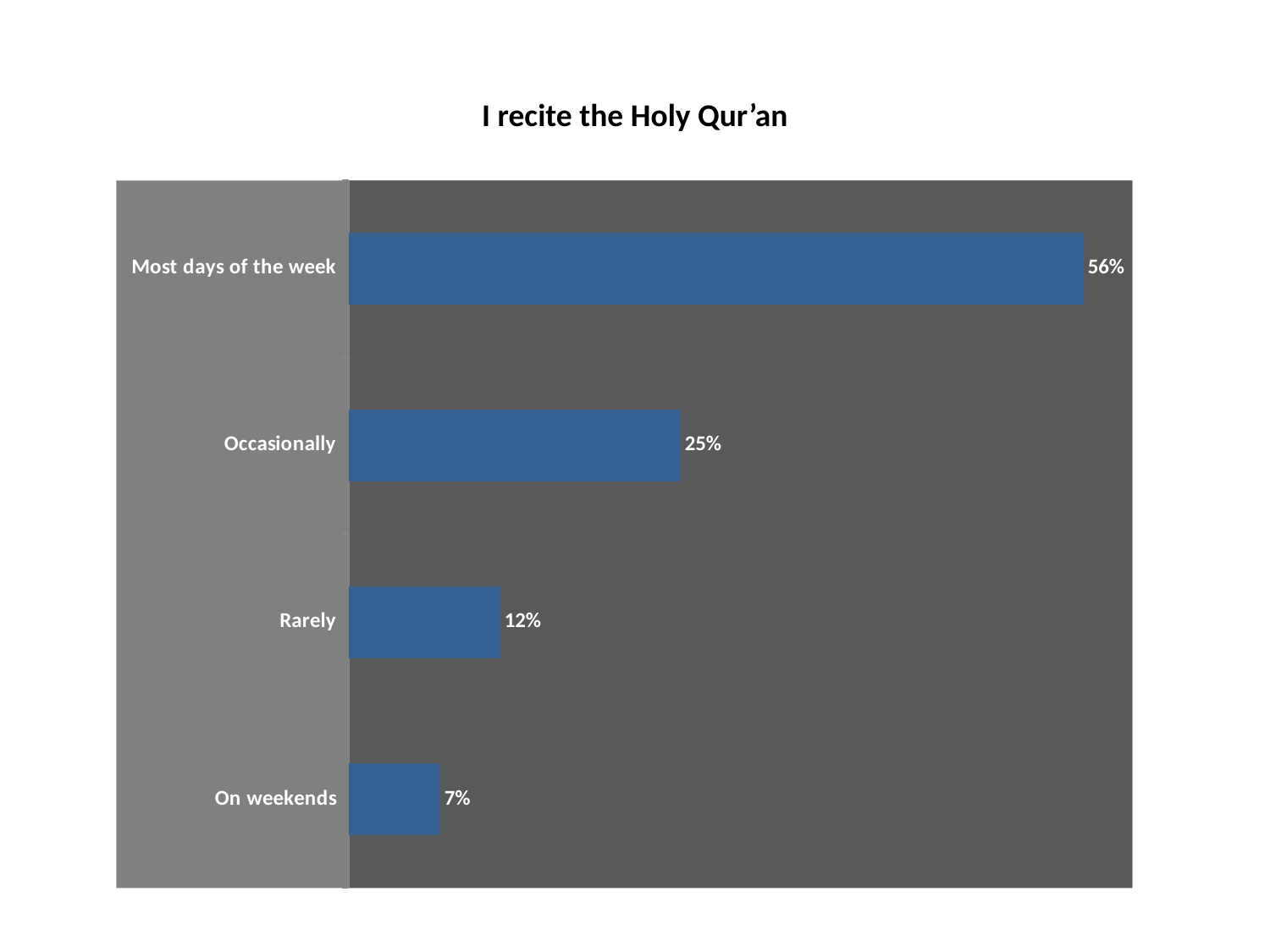
What is the value for "Rarely"? 12% Which category has the highest value? Most days of the week What kind of chart is shown on the slide? Bar chart What is the difference between the values for "Most days of the week" and "Occasionally"? 31% What is the value for "Most days of the week"? 56% Which category has the lowest value? On weekends What is the title of the chart? I recite the Holy Qur’an What is the value for "On weekends"? 7% Which is larger, the value for "Occasionally" or the value for "Rarely"? Occasionally How many categories are shown in the chart? 4 What is the difference between the values for "Rarely" and "On weekends"? 5% What is the value for "Occasionally"? 25%